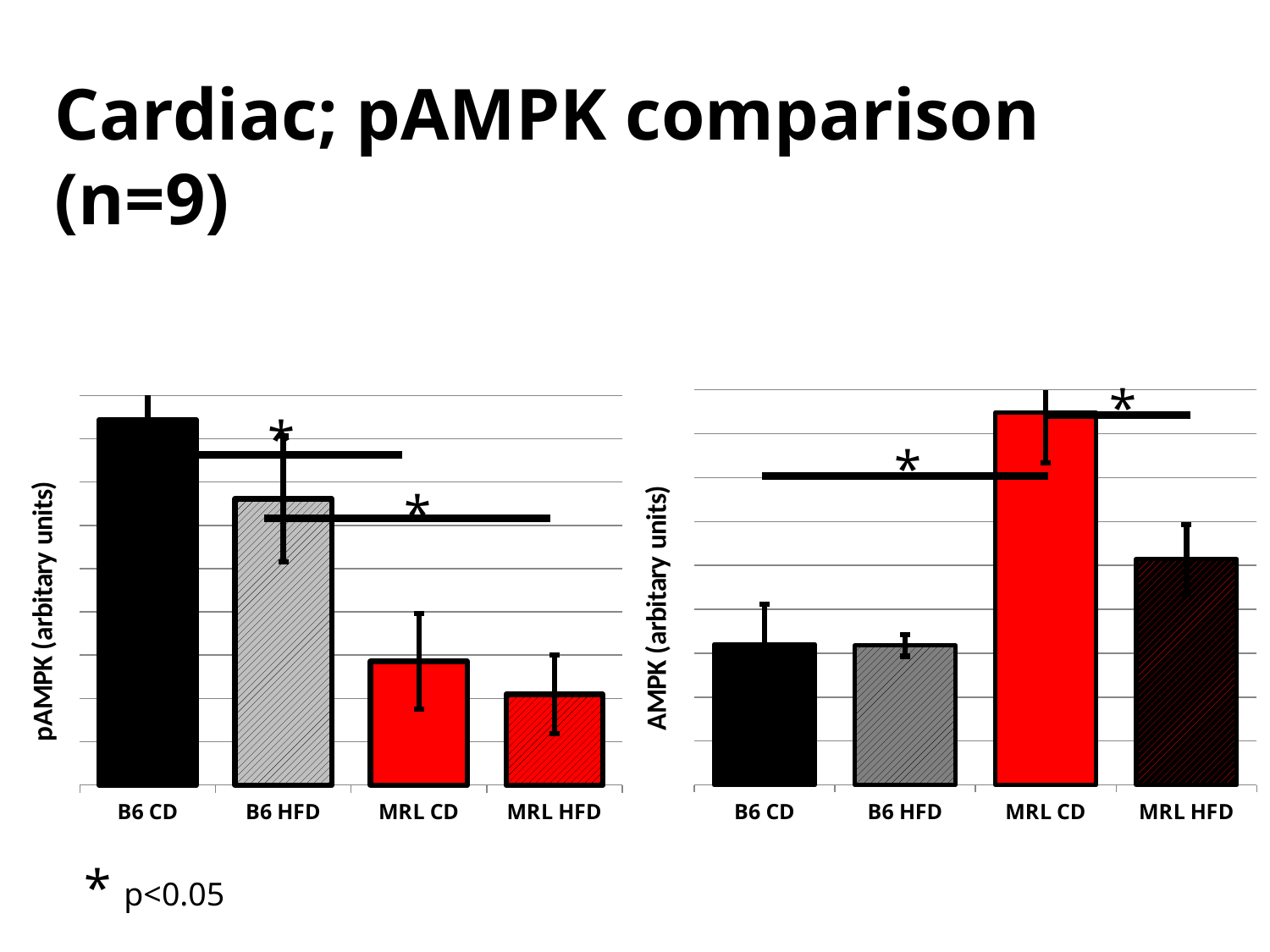
In the left chart (pAMPK), which category has the highest value? B6 CD What is the title of the slide? Cardiac; pAMPK comparison (n=9) What is the y-axis title of the right chart? AMPK (arbitary units) How many charts are shown on the slide? 2 In the left chart (pAMPK), which category has the lowest value? MRL HFD In the right chart (AMPK), which category has the highest value? MRL CD In the left chart, do the bar values rise or fall from B6 CD to MRL HFD along the x axis? fall In the left chart (pAMPK), how many categories are shown on the x axis? 4 In the left chart (pAMPK), which is larger, the value for B6 HFD or the value for MRL CD? B6 HFD In the right chart (AMPK), which is larger, the value for B6 HFD or the value for MRL CD? MRL CD In the right chart (AMPK), which is larger, the value for MRL HFD or the value for B6 CD? MRL HFD What kind of chart is the left chart on the slide? bar chart